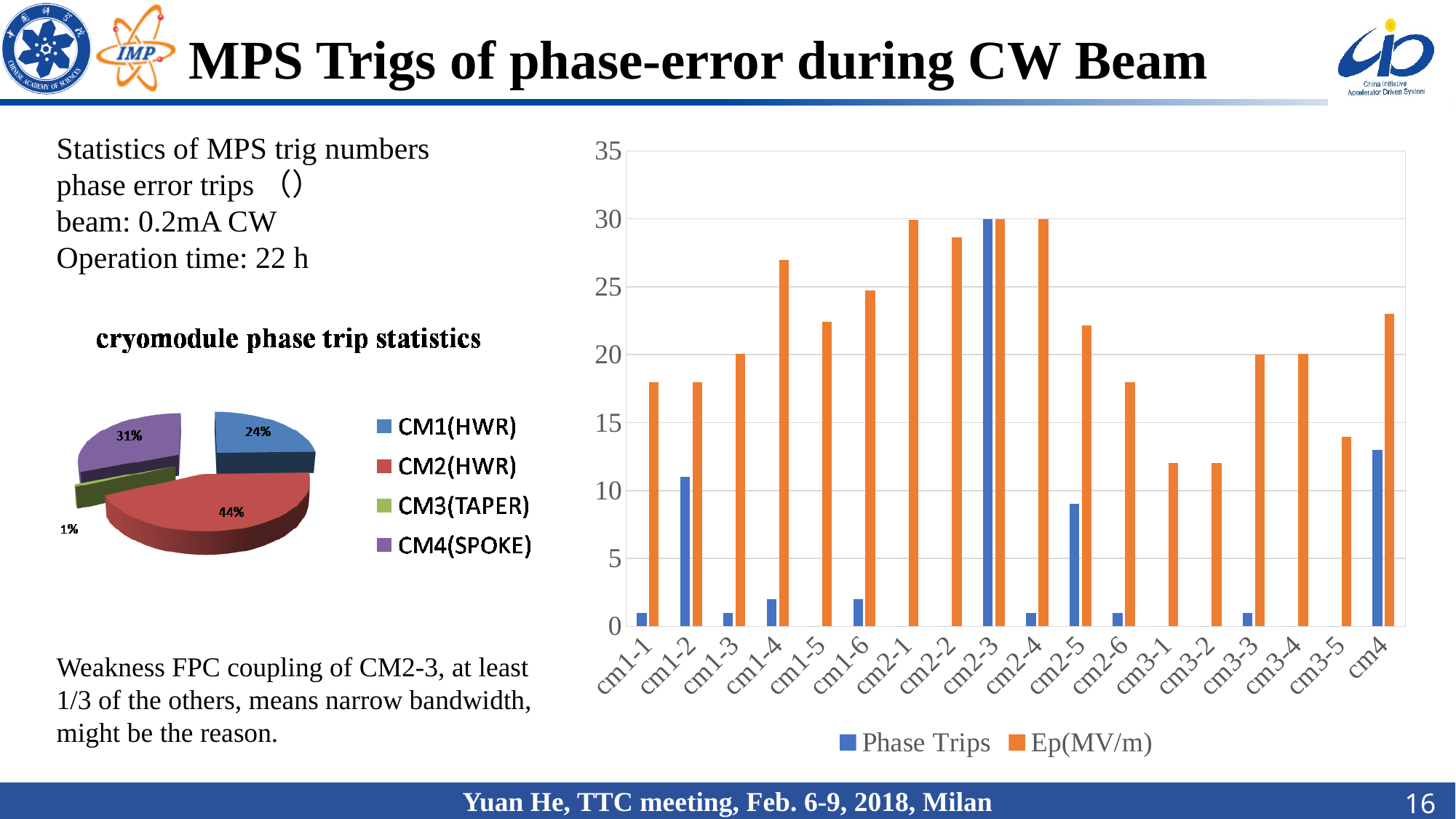
In the pie chart titled 'cryomodule phase trip statistics', what share of phase trips does CM4(SPOKE) account for? 31% In the pie chart titled 'cryomodule phase trip statistics', which cryomodule has the smallest share of phase trips? CM3(TAPER) In the pie chart titled 'cryomodule phase trip statistics', which cryomodule has the largest share of phase trips? CM2(HWR) In the bar chart on the right, how many series does the legend list? 2 What kind of chart is the chart on the right side of the slide? bar chart In the bar chart on the right, how many cavity categories are shown on the x axis? 18 In the bar chart on the right, is the Ep(MV/m) value for cm1-4 greater or less than 25? greater In the bar chart on the right, which is larger: the Ep(MV/m) value for cm2-1 or for cm3-1? cm2-1 In the pie chart titled 'cryomodule phase trip statistics', what share of phase trips does CM2(HWR) account for? 44% In the bar chart on the right, which category has the highest number of Phase Trips? cm2-3 In the pie chart titled 'cryomodule phase trip statistics', how many slices does the legend list? 4 In the bar chart on the right, is the Phase Trips value for cm2-5 greater or less than 10? less